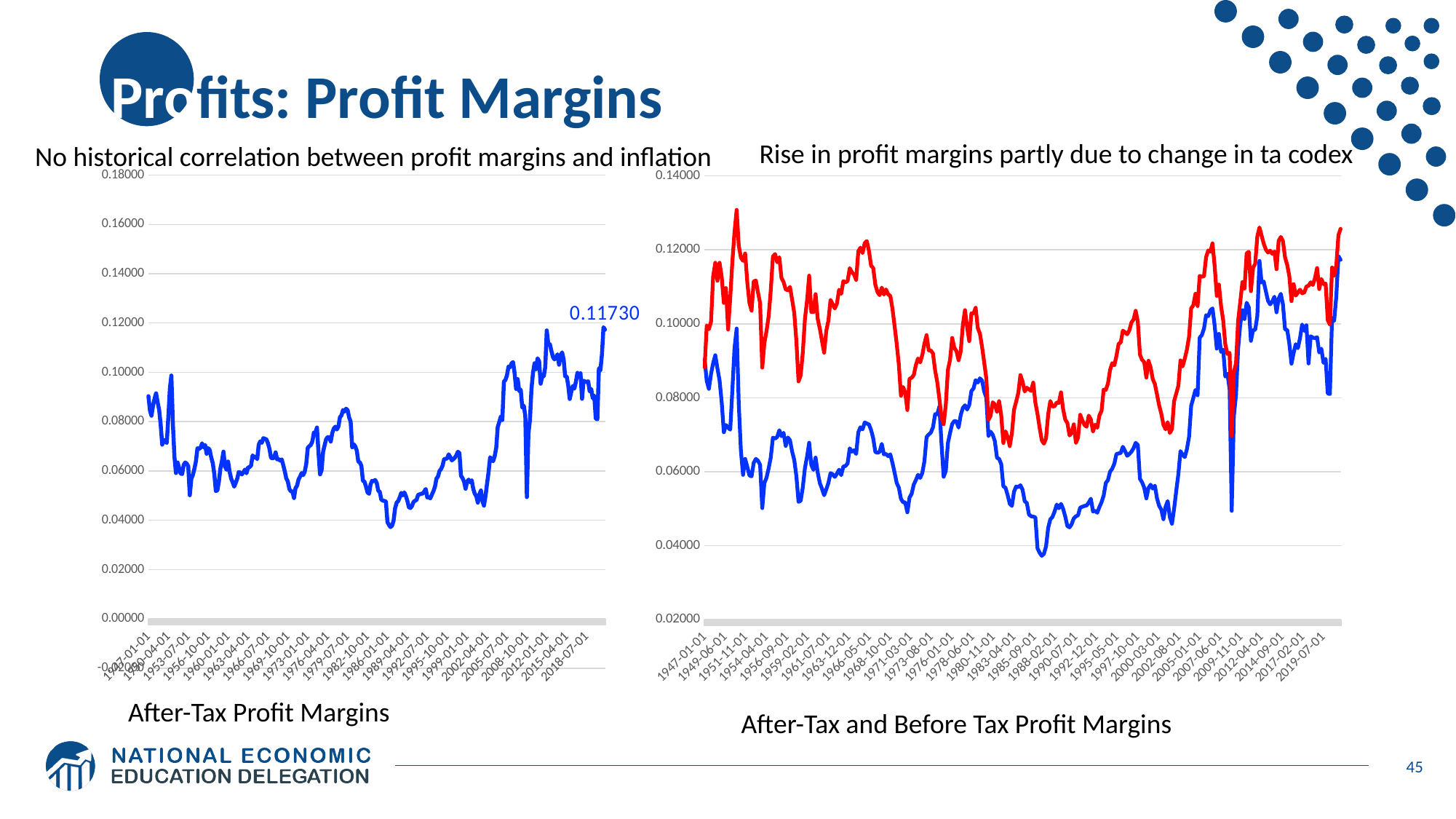
In the left chart (After-Tax Profit Margins), does the line end higher or lower than where it starts in 1947? higher What kind of chart is the right chart, titled "After-Tax and Before Tax Profit Margins"? line chart In the right chart (After-Tax and Before Tax Profit Margins), is the lowest value of the blue line greater or less than 0.06? less How many lines are plotted in the right chart, titled "After-Tax and Before Tax Profit Margins"? 2 What is the title shown below the left chart? After-Tax Profit Margins In the right chart (After-Tax and Before Tax Profit Margins), which line is generally higher, the red line or the blue line? the red line In the right chart (After-Tax and Before Tax Profit Margins), is the highest value of the red line greater or less than 0.12? greater What is the highest tick value shown on the y axis of the left chart (After-Tax Profit Margins)? 0.18000 In the left chart (After-Tax Profit Margins), is the final value of the line greater or less than 0.10? greater What kind of chart is the left chart, titled "After-Tax Profit Margins"? line chart In the left chart (After-Tax Profit Margins), what value is printed as the data label at the end of the line? 0.11730